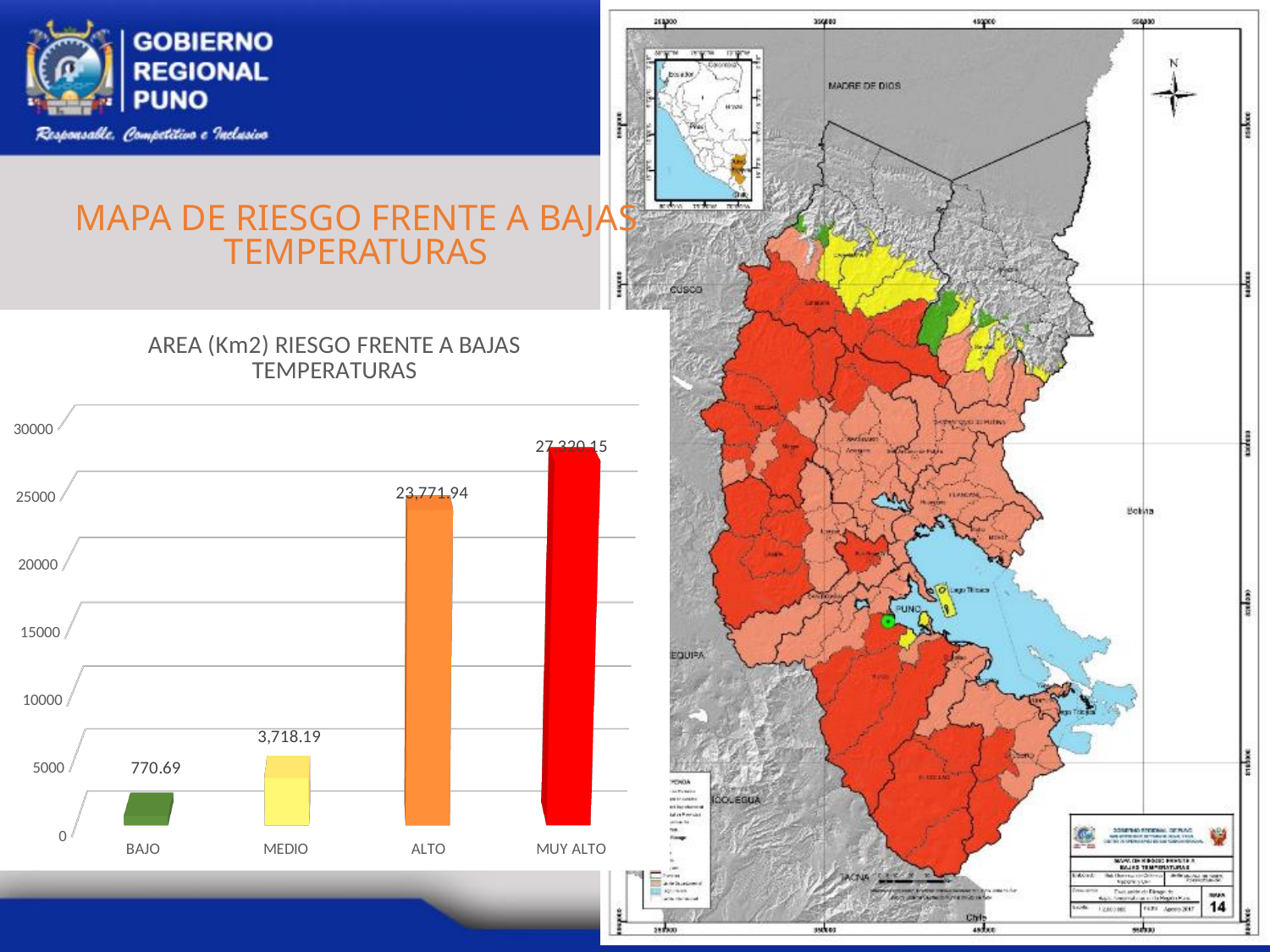
What is the difference between the MUY ALTO and ALTO values? 3,548.21 Which category has the highest area value? MUY ALTO What is the title of the chart? AREA (Km2) RIESGO FRENTE A BAJAS TEMPERATURAS Is the value for ALTO greater or less than 20000? greater How many categories are shown on the x axis of the chart? 4 Which category has the lowest area value? BAJO What is the area value shown for the ALTO category? 23,771.94 Which is larger, the value for MEDIO or the value for ALTO? ALTO What kind of chart is shown on the slide? Bar chart What is the area value shown for the MUY ALTO category? 27,320.15 What is the area value shown for the MEDIO category? 3,718.19 What is the area value shown for the BAJO category? 770.69